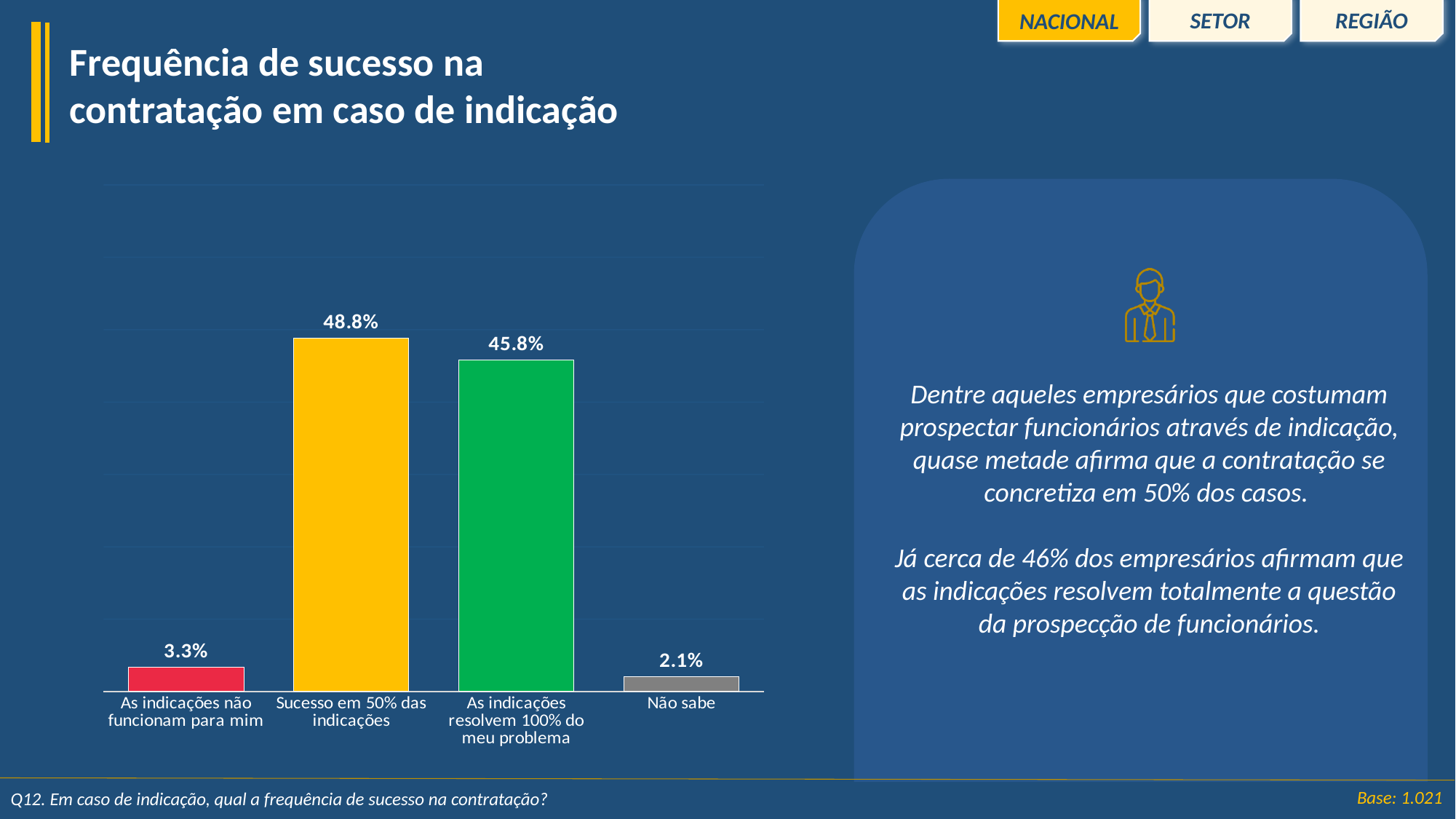
Which category has the highest value? Sucesso em 50% das indicações How many categories are shown in the chart? 4 What is the difference between "Sucesso em 50% das indicações" and "As indicações resolvem 100% do meu problema"? 3.0% What is the value for "As indicações não funcionam para mim"? 3.3% What is the value for "As indicações resolvem 100% do meu problema"? 45.8% What is the value for "Sucesso em 50% das indicações"? 48.8% What is the difference between "As indicações não funcionam para mim" and "Não sabe"? 1.2% What is the value for "Não sabe"? 2.1% What kind of chart is shown on the slide? Bar chart Which is larger: "As indicações não funcionam para mim" or "Não sabe"? As indicações não funcionam para mim What colour is the bar for "As indicações resolvem 100% do meu problema"? Green Which category has the lowest value? Não sabe